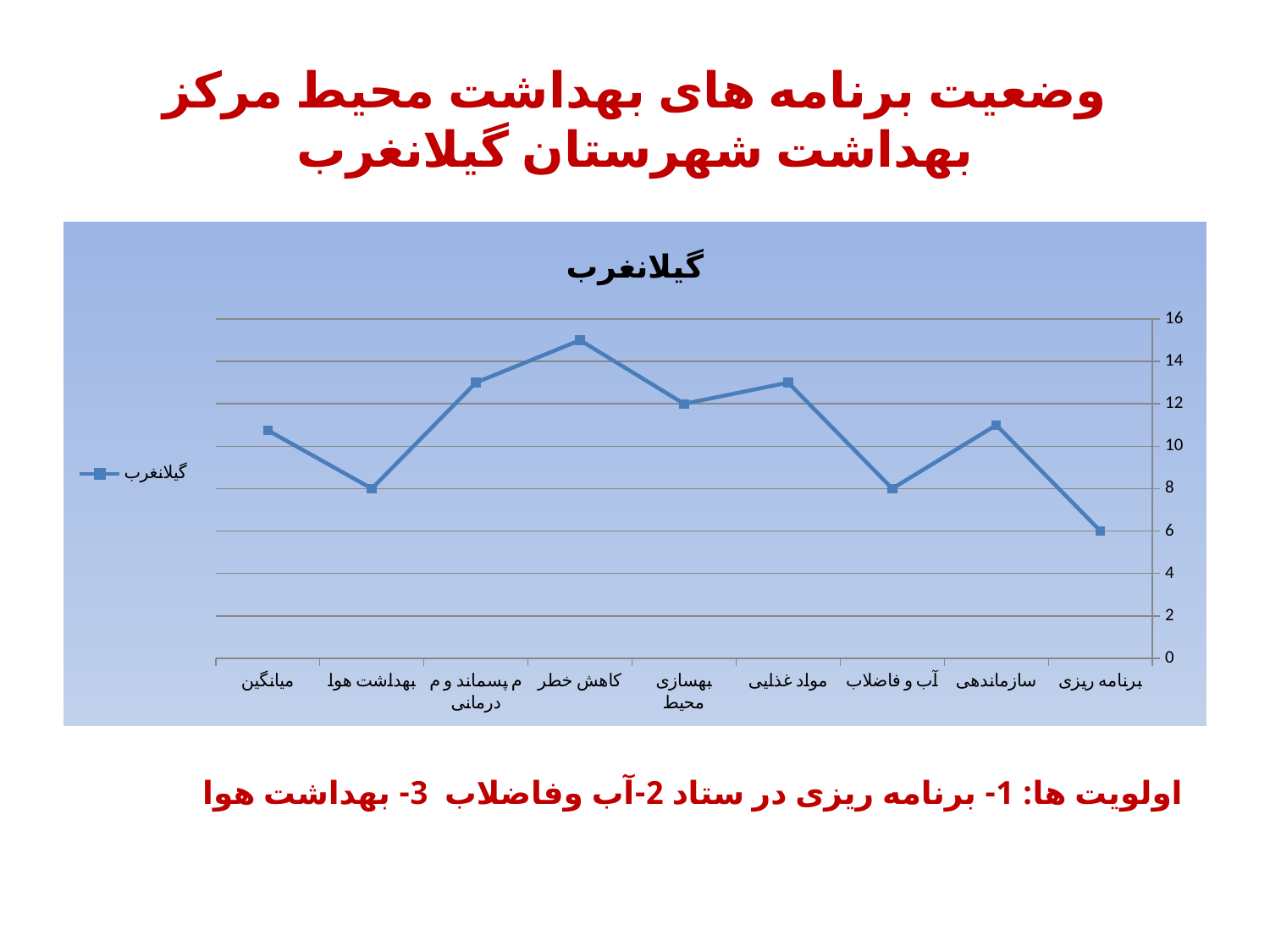
Is the value for سازماندهی greater or less than 10? greater What is the value for برنامه ریزی? 6 How many series does the legend list? 1 What is the difference between the values for بهسازی محیط and برنامه ریزی? 6 How many categories are plotted along the x axis? 9 Which category has the lowest value? برنامه ریزی What is the title of the chart? گیلانغرب What type of chart is shown on the slide? Line chart Which category has the highest value? کاهش خطر What is the value for آب و فاضلاب? 8 Is the value for کاهش خطر greater or less than 14? greater What is the value for بهسازی محیط? 12